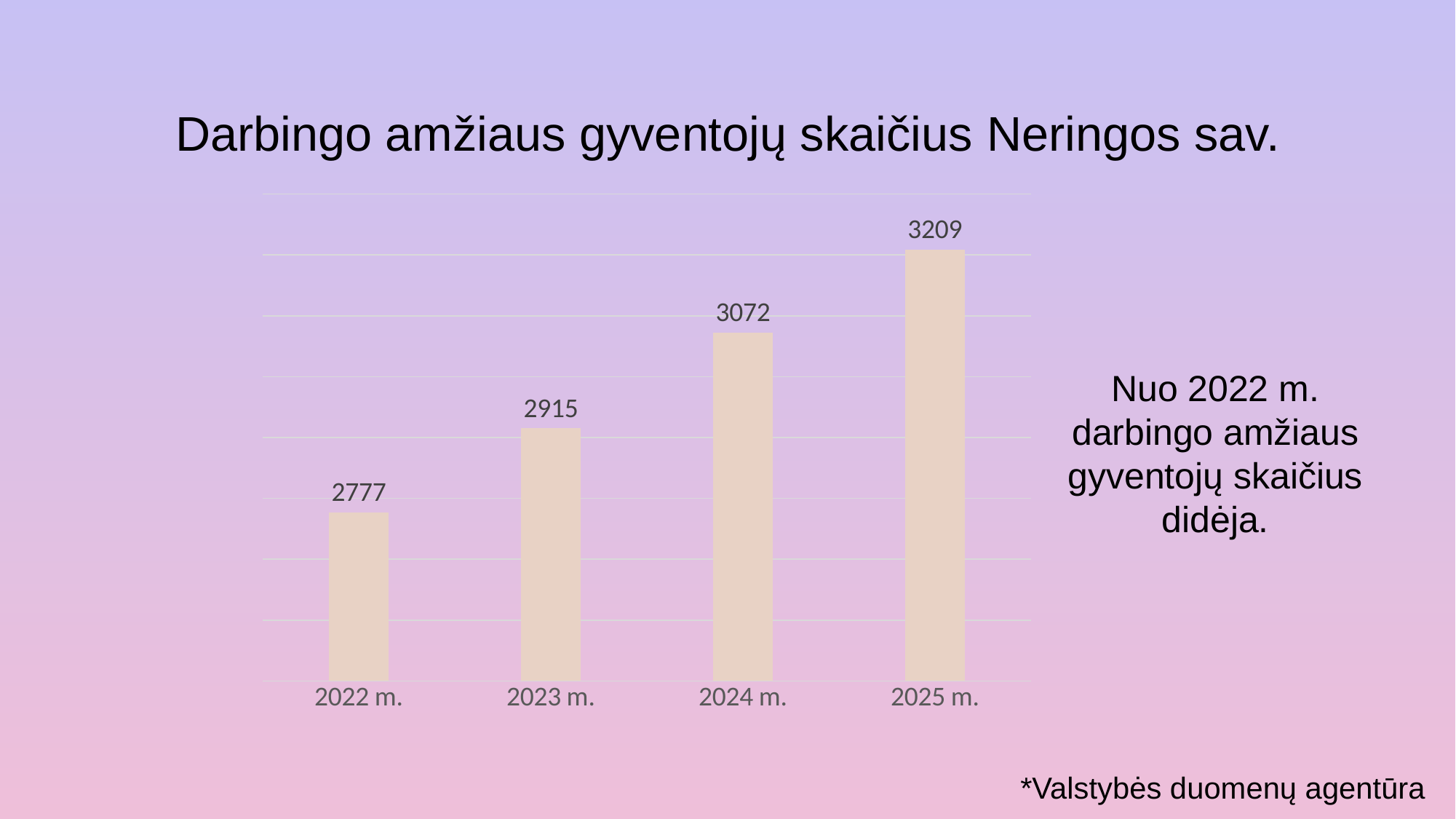
Which year has the highest value? 2025 m. What is the value for 2022 m.? 2777 What is the value for 2024 m.? 3072 What kind of chart is shown on the slide? bar chart Which year has the lowest value? 2022 m. Do the values rise or fall from 2022 m. to 2025 m.? rise What is the value for 2023 m.? 2915 What is the value for 2025 m.? 3209 What is the difference between the values for 2024 m. and 2023 m.? 157 What is the difference between the values for 2025 m. and 2022 m.? 432 Which is larger, the value for 2023 m. or the value for 2024 m.? 2024 m. How many years are shown on the chart? 4